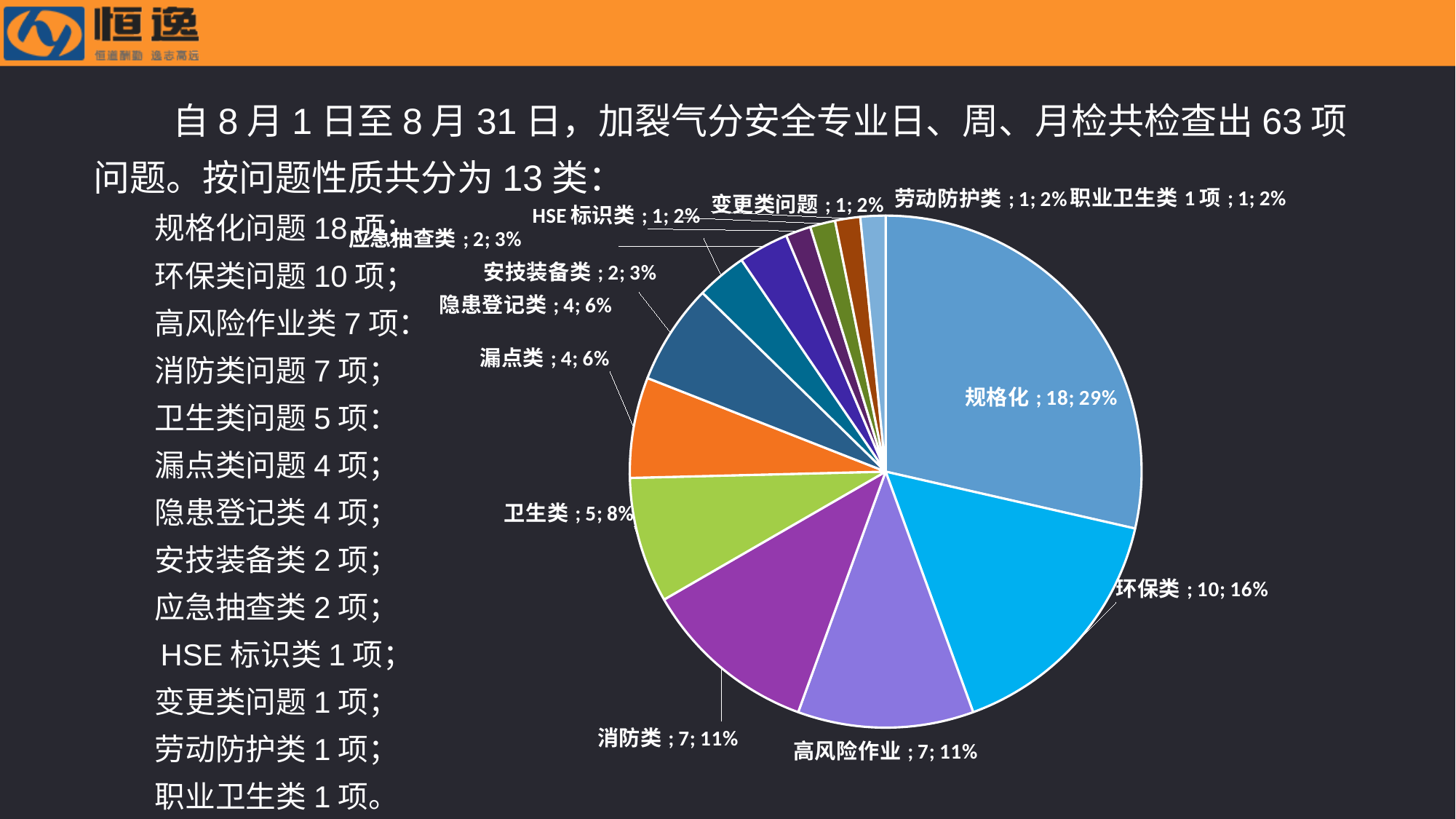
What percentage share does the 环保类 slice have? 16% Which category has the largest slice in the pie chart? 规格化 What kind of chart is shown on the slide? pie chart Which is larger, the value for 卫生类 or the value for 漏点类? 卫生类 What percentage share does the 消防类 slice have? 11% What is the difference between the values for 规格化 and 环保类? 8 What is the value shown for 高风险作业 in the pie chart? 7 What is the value shown for 卫生类 in the pie chart? 5 How many slices does the pie chart have? 13 What is the value shown for 规格化 in the pie chart? 18 What is the value shown for 隐患登记类 in the pie chart? 4 What percentage share does the 安技装备类 slice have? 3%